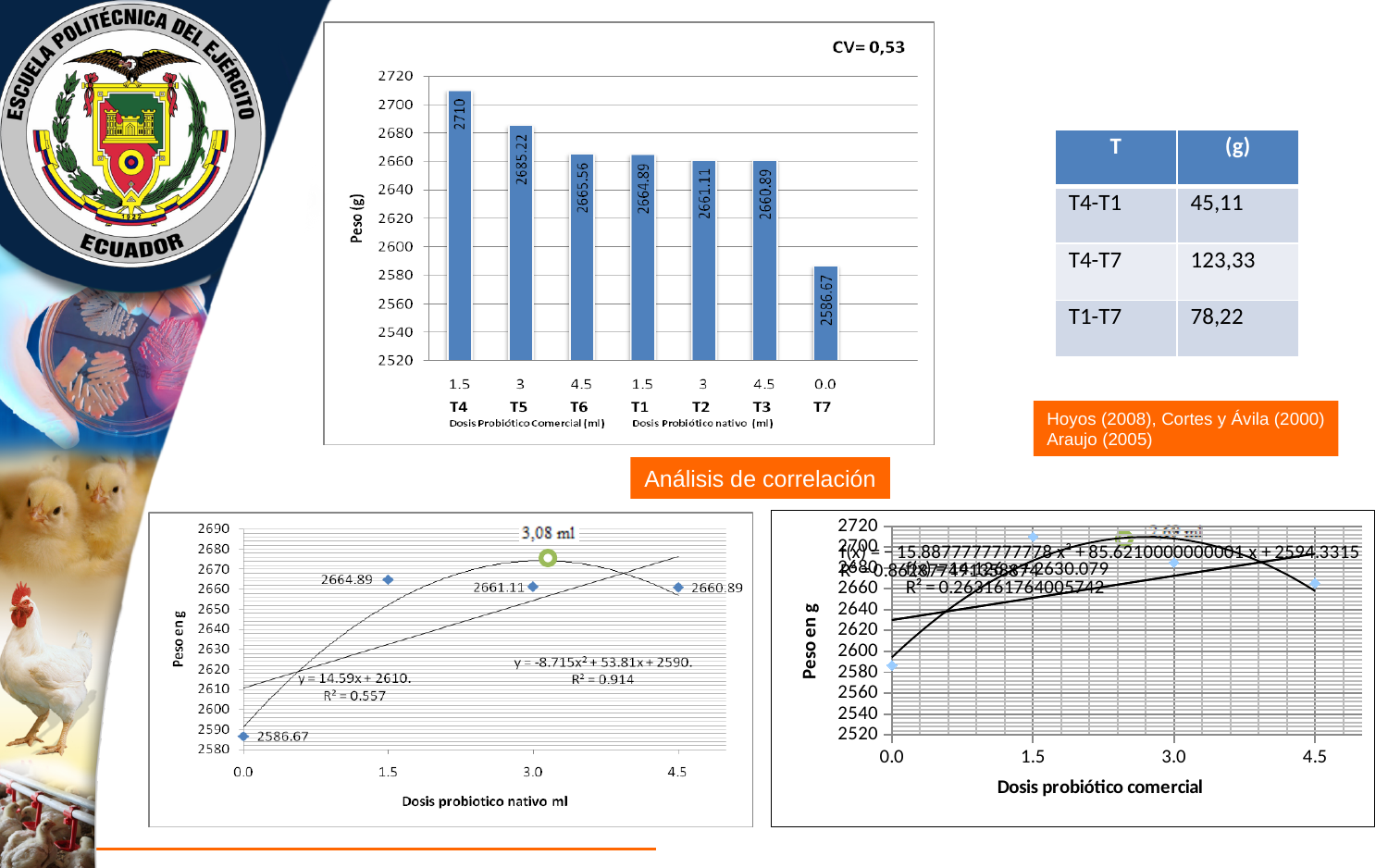
How many bars are in the top bar chart? 7 In the bottom-left chart (Dosis probiotico nativo ml), what is the R² of the quadratic equation? 0.914 In the top bar chart, what is the value for T4? 2710 What CV value is shown on the top bar chart? CV= 0,53 In the top bar chart, what is the difference between the values for T4 and T5? 24.78 In the top bar chart, which treatment has the lowest weight? T7 In the top bar chart, which treatment has the highest weight? T4 What type of chart is the top chart? bar chart In the top bar chart, what is the value for T7? 2586.67 In the bottom-left chart (Dosis probiotico nativo ml), what is the value at dose 1.5? 2664.89 In the top bar chart, which is larger, the value for T5 or the value for T1? T5 In the bottom-right chart (Dosis probiótico comercial), is the value at dose 0.0 greater or less than 2600? less